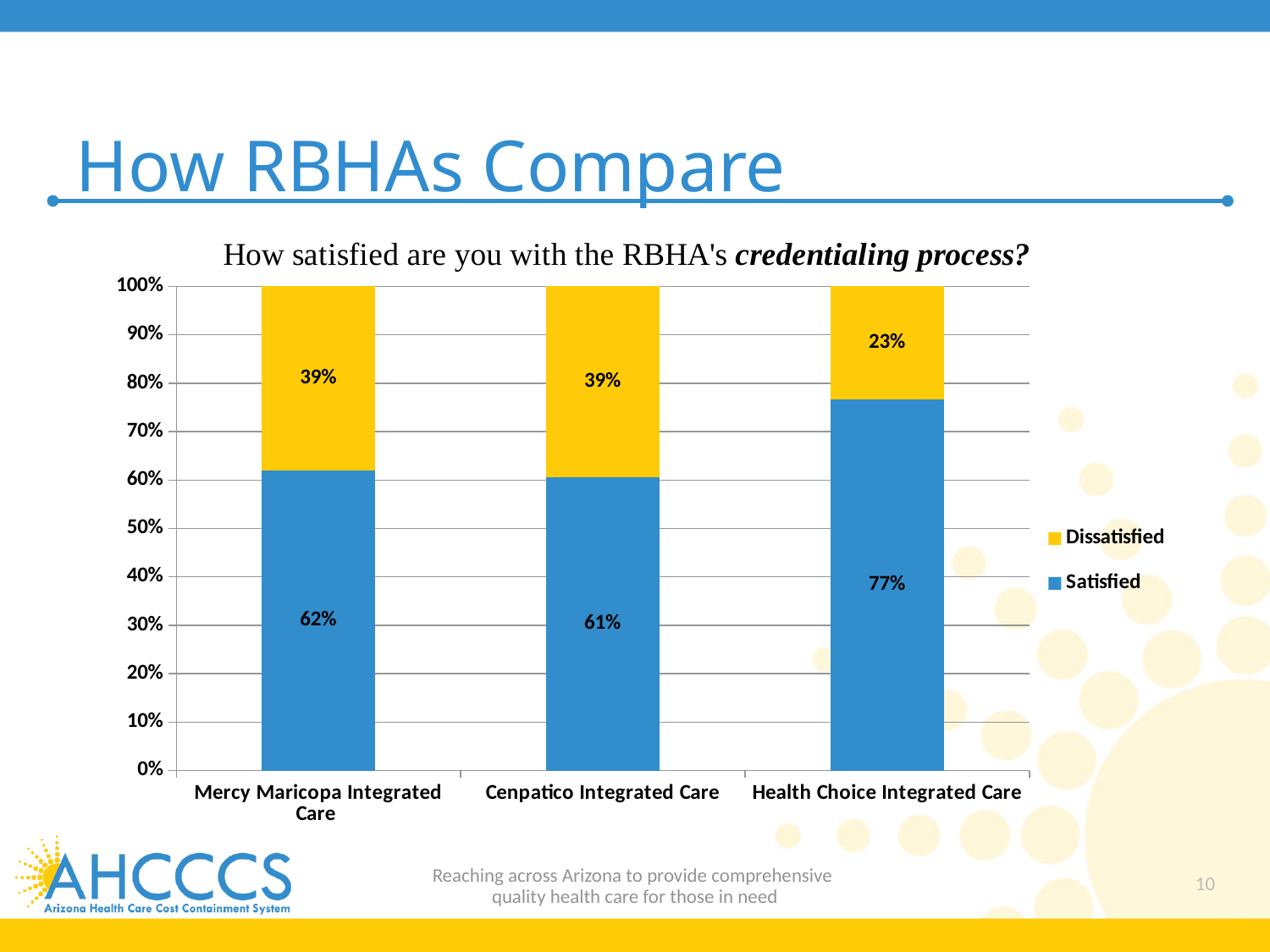
Which RBHA has the highest Satisfied percentage? Health Choice Integrated Care Which RBHA has the lowest Dissatisfied percentage? Health Choice Integrated Care How many RBHAs are shown on the x axis of the chart? 3 What percentage of respondents were satisfied with Mercy Maricopa Integrated Care's credentialing process? 62% What is the Dissatisfied value for Health Choice Integrated Care? 23% How many percentage points higher is the Satisfied value for Health Choice Integrated Care than for Cenpatico Integrated Care? 16 percentage points What is the Satisfied value for Cenpatico Integrated Care? 61% Which has a larger Satisfied value, Mercy Maricopa Integrated Care or Cenpatico Integrated Care? Mercy Maricopa Integrated Care How many series does the chart's legend list? 2 What kind of chart is shown on the slide? Stacked bar chart Which colour represents the Dissatisfied series in the chart? Yellow Is the Satisfied value for Health Choice Integrated Care greater or less than 70%? greater